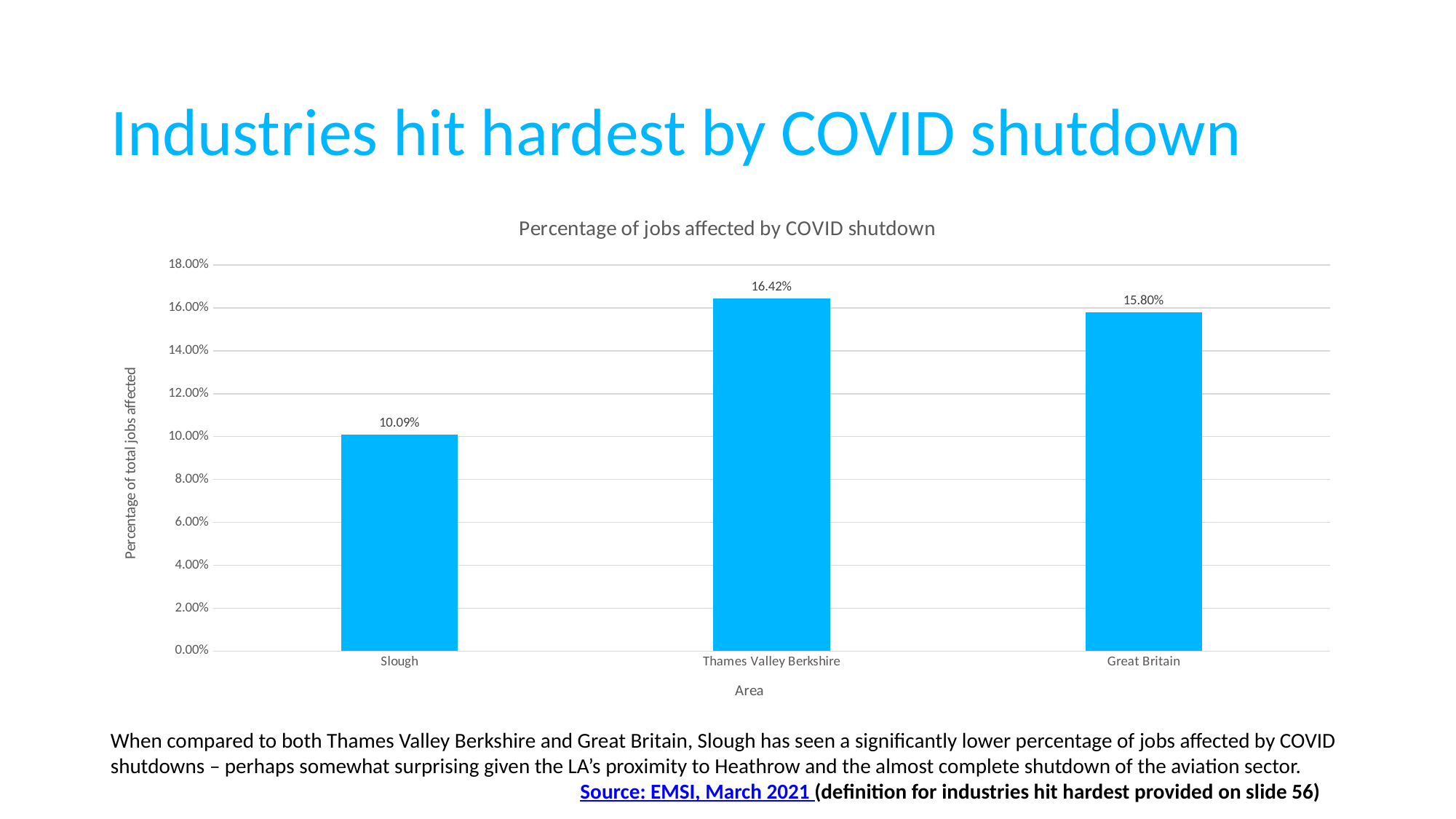
What is the percentage of jobs affected by COVID shutdown for Slough? 10.09% What type of chart is shown on the slide? Bar chart What is the difference in percentage points between Thames Valley Berkshire and Slough? 6.33% What is the difference in percentage points between Thames Valley Berkshire and Great Britain? 0.62% What is the title of the chart? Percentage of jobs affected by COVID shutdown Which area has the lowest percentage of jobs affected by COVID shutdown? Slough Which has a higher percentage of jobs affected: Slough or Great Britain? Great Britain Is the value for Slough greater or less than 12.00%? less What is the percentage of jobs affected by COVID shutdown for Thames Valley Berkshire? 16.42% How many areas are shown on the chart? 3 Which area has the highest percentage of jobs affected by COVID shutdown? Thames Valley Berkshire What is the percentage of jobs affected by COVID shutdown for Great Britain? 15.80%